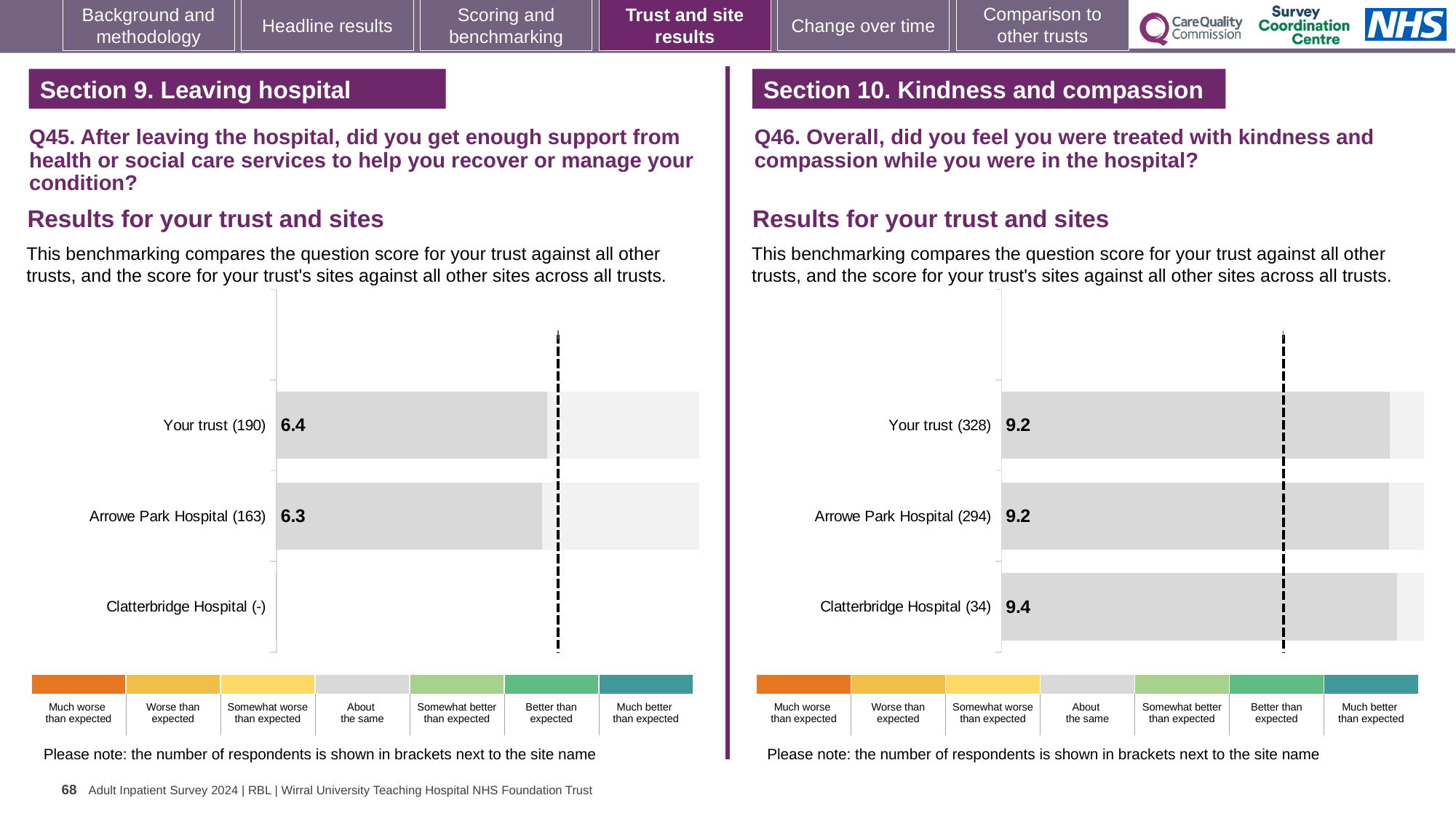
How many rows (trust and sites) are listed in the Q45 chart on the left? 3 In the Q46 chart on the right, what is the score for Clatterbridge Hospital? 9.4 In the Q46 chart on the right, which site or trust has the highest score? Clatterbridge Hospital In the Q46 chart on the right, is the score for Arrowe Park Hospital larger than, smaller than, or equal to the score for Your trust? equal In the Q45 chart on the left, what is the score for Arrowe Park Hospital? 6.3 In the Q46 chart on the right, what is the score for Your trust? 9.2 In the Q45 chart on the left, what is the score for Your trust? 6.4 What kind of chart is used in the Q46 chart on the right? bar chart How many respondents are shown in brackets for Your trust in the Q45 chart on the left? 190 In the Q46 chart on the right, what is the difference between the scores for Clatterbridge Hospital and Arrowe Park Hospital? 0.2 In the Q45 chart on the left, what is the difference between the scores for Your trust and Arrowe Park Hospital? 0.1 How many respondents are shown in brackets for Clatterbridge Hospital in the Q46 chart on the right? 34